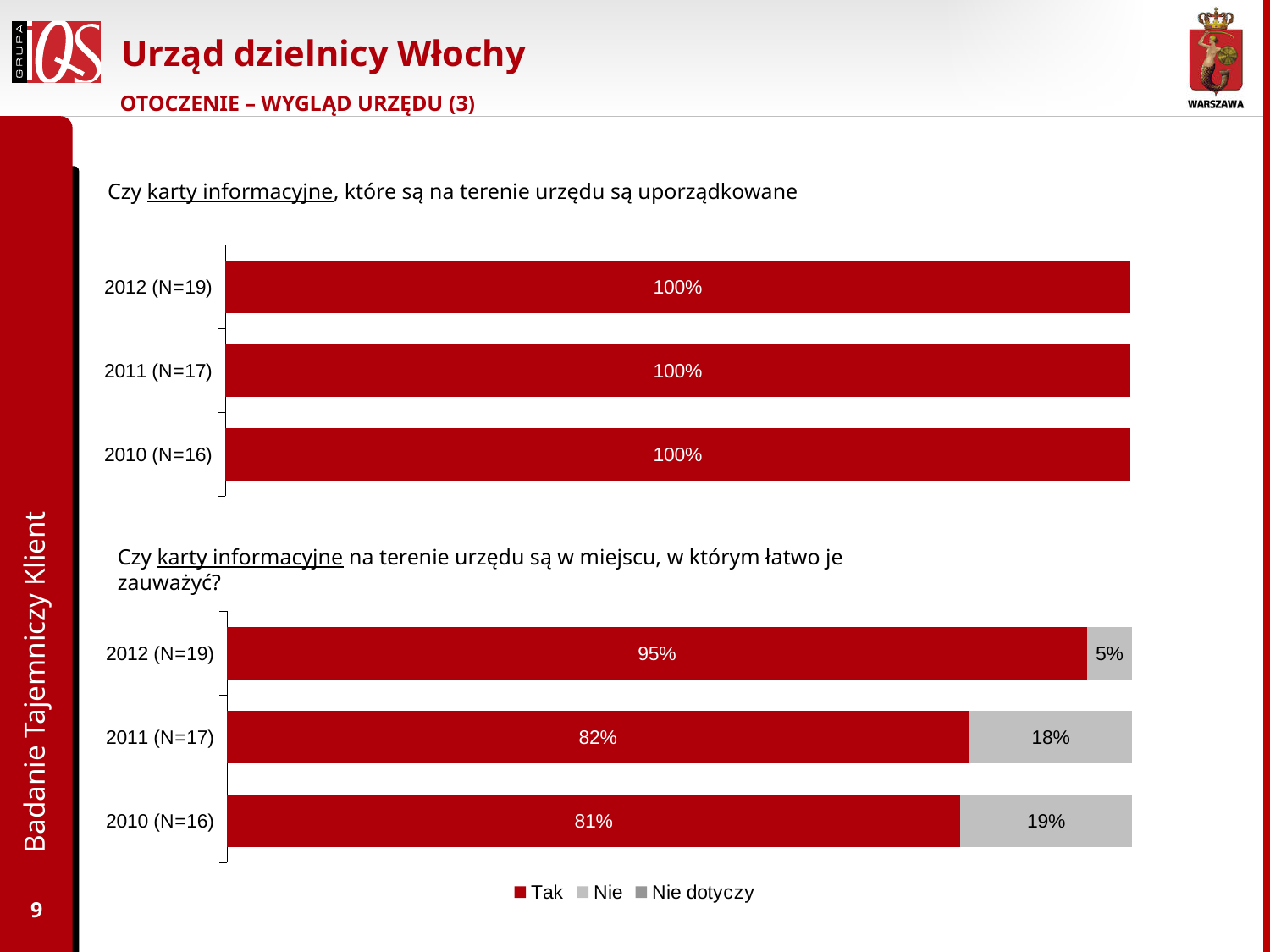
In the bottom chart ("Czy karty informacyjne na terenie urzędu są w miejscu, w którym łatwo je zauważyć?"), what is the total of the stacked bar for 2011 (N=17)? 100% In the bottom chart ("Czy karty informacyjne na terenie urzędu są w miejscu, w którym łatwo je zauważyć?"), what is the difference between the "Tak" values for 2012 (N=19) and 2011 (N=17)? 13 percentage points How many year categories are shown in the top chart ("Czy karty informacyjne, które są na terenie urzędu są uporządkowane")? 3 In the top chart ("Czy karty informacyjne, które są na terenie urzędu są uporządkowane"), what is the value shown for 2011 (N=17)? 100% In the bottom chart ("Czy karty informacyjne na terenie urzędu są w miejscu, w którym łatwo je zauważyć?"), what is the "Tak" value for 2012 (N=19)? 95% In the bottom chart ("Czy karty informacyjne na terenie urzędu są w miejscu, w którym łatwo je zauważyć?"), what is the "Nie" value for 2011 (N=17)? 18% In the bottom chart ("Czy karty informacyjne na terenie urzędu są w miejscu, w którym łatwo je zauważyć?"), which year has the highest "Tak" value? 2012 (N=19) In the bottom chart ("Czy karty informacyjne na terenie urzędu są w miejscu, w którym łatwo je zauważyć?"), which year has the lowest "Nie" value? 2012 (N=19) In the bottom chart ("Czy karty informacyjne na terenie urzędu są w miejscu, w którym łatwo je zauważyć?"), is the "Nie" value larger for 2010 (N=16) or for 2012 (N=19)? 2010 (N=16) How many series does the legend at the bottom of the slide list? 3 In the bottom chart ("Czy karty informacyjne na terenie urzędu są w miejscu, w którym łatwo je zauważyć?"), what is the "Tak" value for 2010 (N=16)? 81% What type of chart is the bottom chart ("Czy karty informacyjne na terenie urzędu są w miejscu, w którym łatwo je zauważyć?")? Stacked bar chart